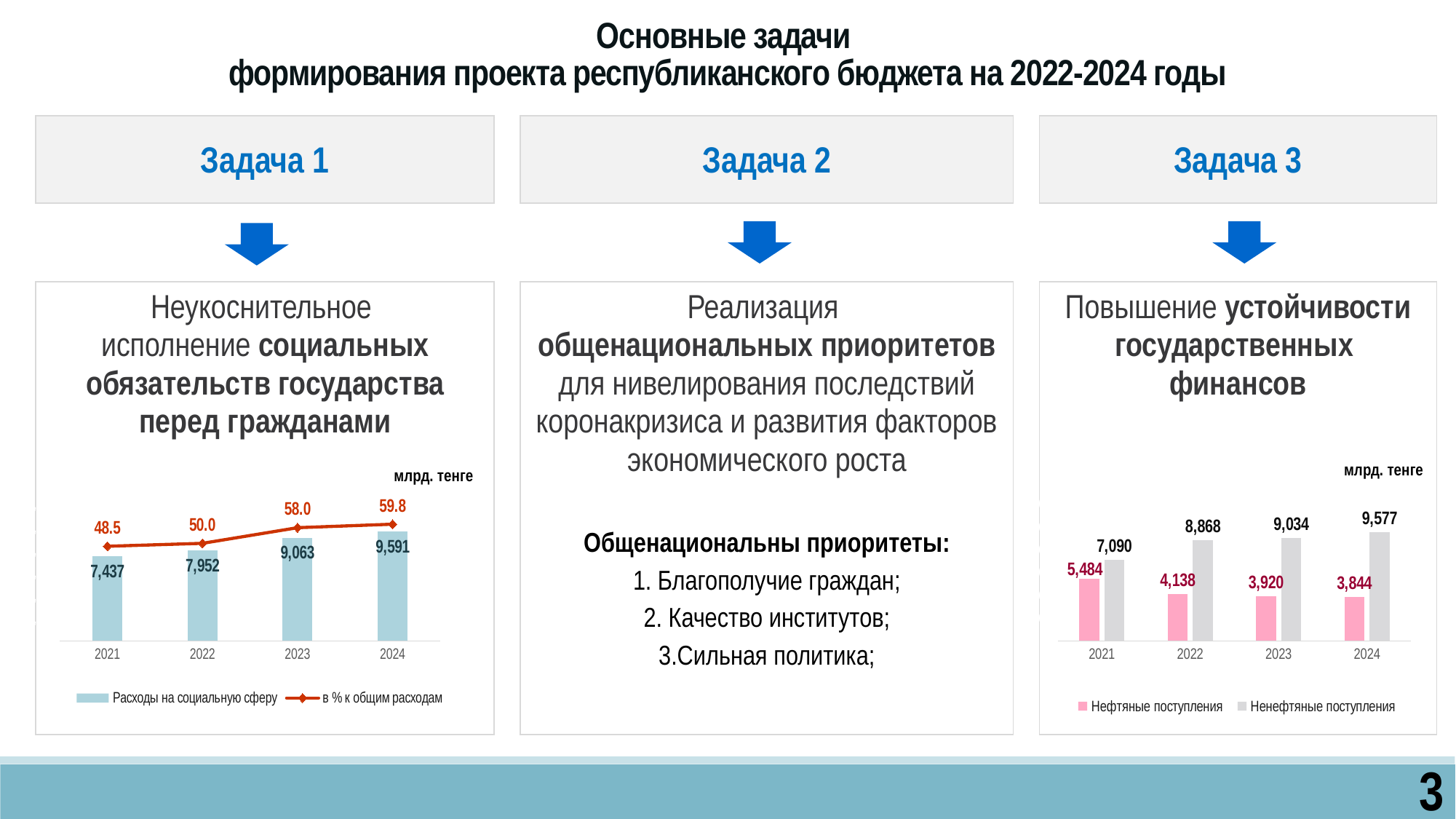
In the left chart (under Задача 1), what is the value of Расходы на социальную сферу for 2023? 9,063 In the left chart (under Задача 1), what is the difference between the Расходы на социальную сферу values for 2024 and 2021? 2,154 In the right chart (under Задача 3), what is the value of Ненефтяные поступления for 2024? 9,577 In the right chart (under Задача 3), what is the value of Нефтяные поступления for 2022? 4,138 In the right chart (under Задача 3), how many years are shown on the x axis? 4 In the left chart (under Задача 1), how many series does the legend list? 2 In the left chart (under Задача 1), what is the value of в % к общим расходам for 2021? 48.5 In the left chart (under Задача 1), which year has the highest value of Расходы на социальную сферу? 2024 In the right chart (under Задача 3), which is larger in 2023: Нефтяные поступления or Ненефтяные поступления? Ненефтяные поступления In the left chart (under Задача 1), do the values of в % к общим расходам rise or fall from 2021 to 2024? rise In the right chart (under Задача 3), which year has the lowest value of Нефтяные поступления? 2024 In the right chart (under Задача 3), what is the difference between Ненефтяные поступления and Нефтяные поступления in 2021? 1,606